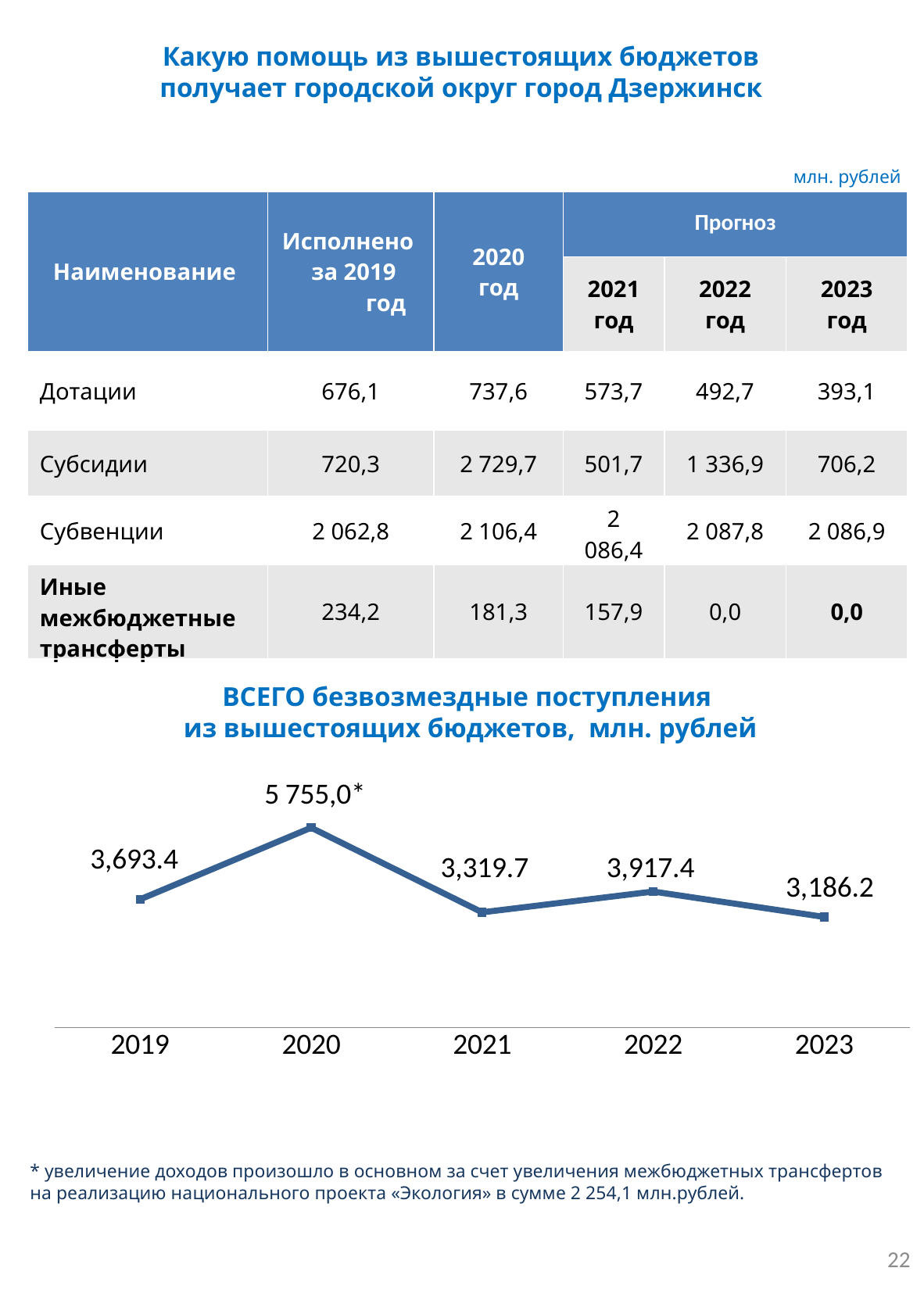
What is the value for 2022 on the line chart? 3,917.4 How many years are plotted on the line chart? 5 What is the value for 2019 on the line chart? 3,693.4 Which year has the highest value on the line chart? 2020 What is the difference between the values for 2022 and 2021 on the line chart? 597.7 What is the title of the line chart? ВСЕГО безвозмездные поступления из вышестоящих бюджетов, млн. рублей What is the value for 2023 on the line chart? 3,186.2 Which is larger on the line chart, the value for 2019 or the value for 2023? 2019 What is the value for 2021 on the line chart? 3,319.7 Which year has the lowest value on the line chart? 2023 What is the value for 2020 on the line chart? 5 755,0 What type of chart is shown on the slide? line chart